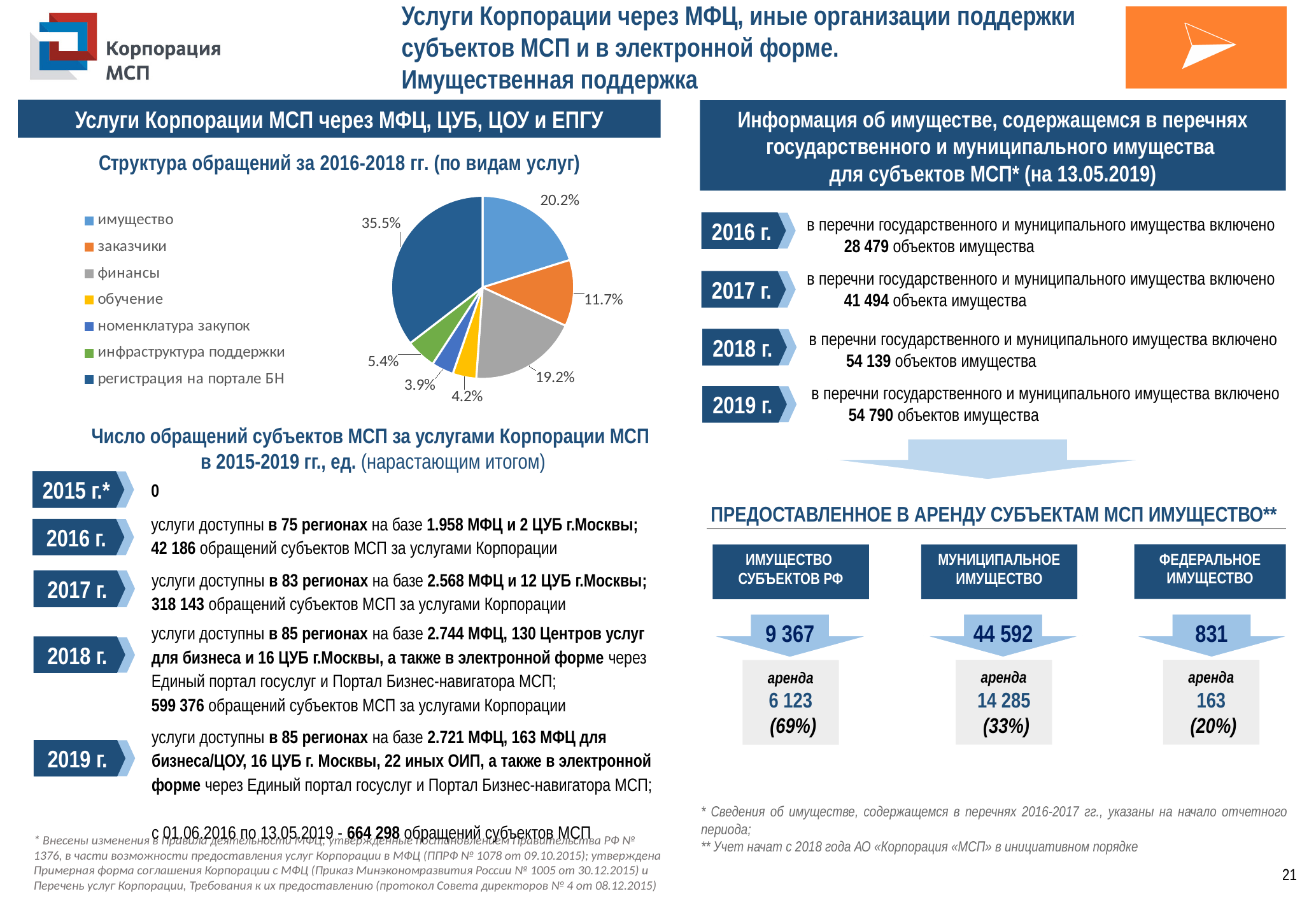
Which category has the smallest slice in the pie chart? номенклатура закупок In the pie chart legend, what colour represents "обучение"? yellow In the pie chart, which is larger: the share for "имущество" or the share for "финансы"? имущество In the pie chart, what share is shown for "финансы"? 19.2% Which category has the largest slice in the pie chart? регистрация на портале БН In the pie chart, what is the difference between the shares for "регистрация на портале БН" and "имущество"? 15.3% In the pie chart, what share is shown for "имущество"? 20.2% In the pie chart, what share is shown for "номенклатура закупок"? 3.9% How many categories does the legend of the pie chart list? 7 In the pie chart, what share is shown for "заказчики"? 11.7% What kind of chart is shown under the title "Структура обращений за 2016-2018 гг. (по видам услуг)"? pie chart In the pie chart, what share is shown for "регистрация на портале БН"? 35.5%